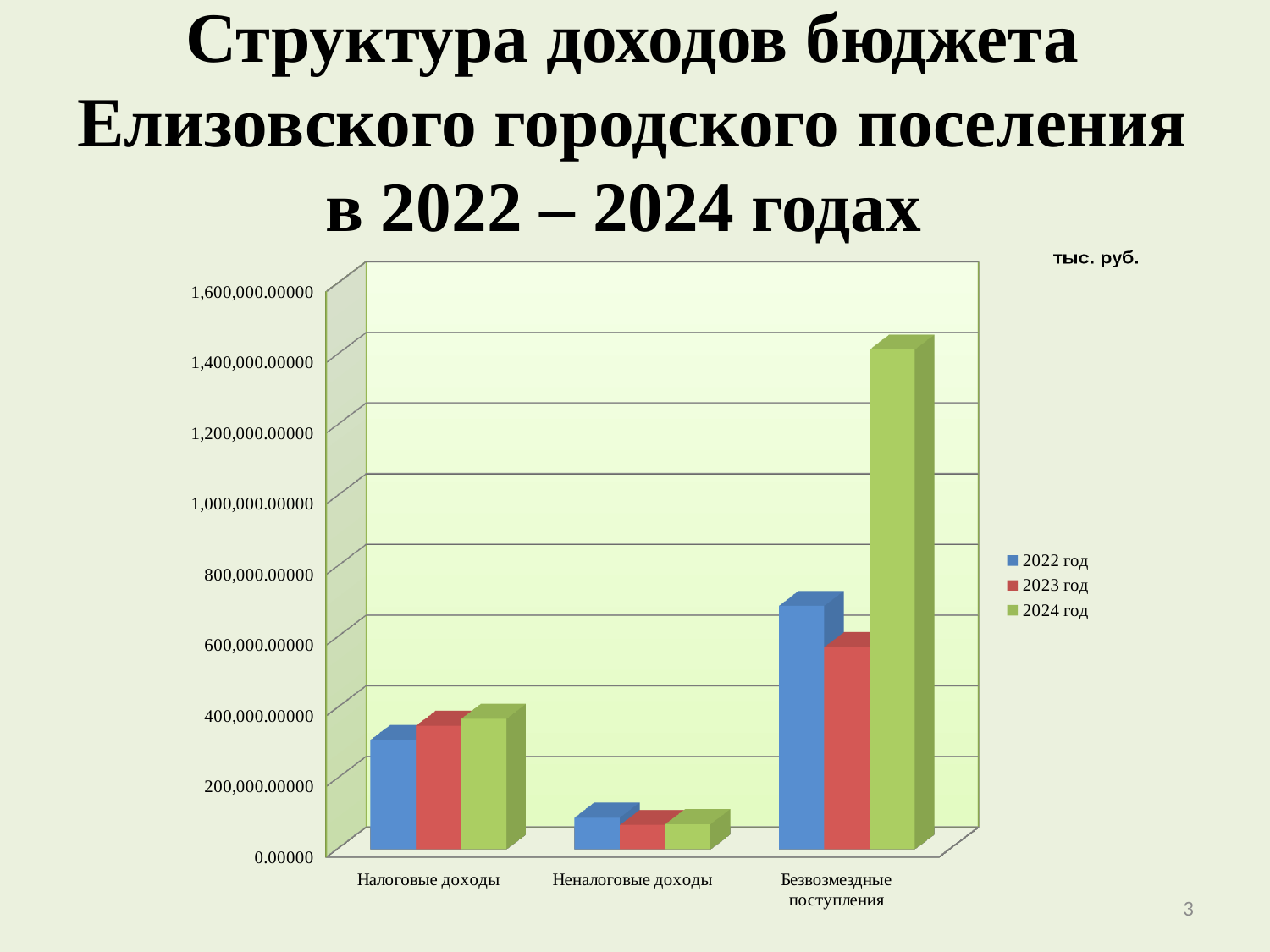
Which category has the highest value for 2024 год? Безвозмездные поступления Is the value for Неналоговые доходы in 2022 год greater or less than 200,000.00000? less What unit is indicated above the chart's legend? тыс. руб. Which category has the highest value for 2022 год? Безвозмездные поступления Is the value for Безвозмездные поступления in 2024 год greater or less than 1,200,000.00000? greater How many categories are shown on the x axis of the chart? 3 How many series does the chart legend list? 3 What kind of chart is shown on the slide? Bar chart Is the value for Безвозмездные поступления in 2022 год greater or less than 600,000.00000? greater Which category has the lowest value for 2022 год? Неналоговые доходы For Безвозмездные поступления, which is larger: the value for 2022 год or the value for 2024 год? 2024 год